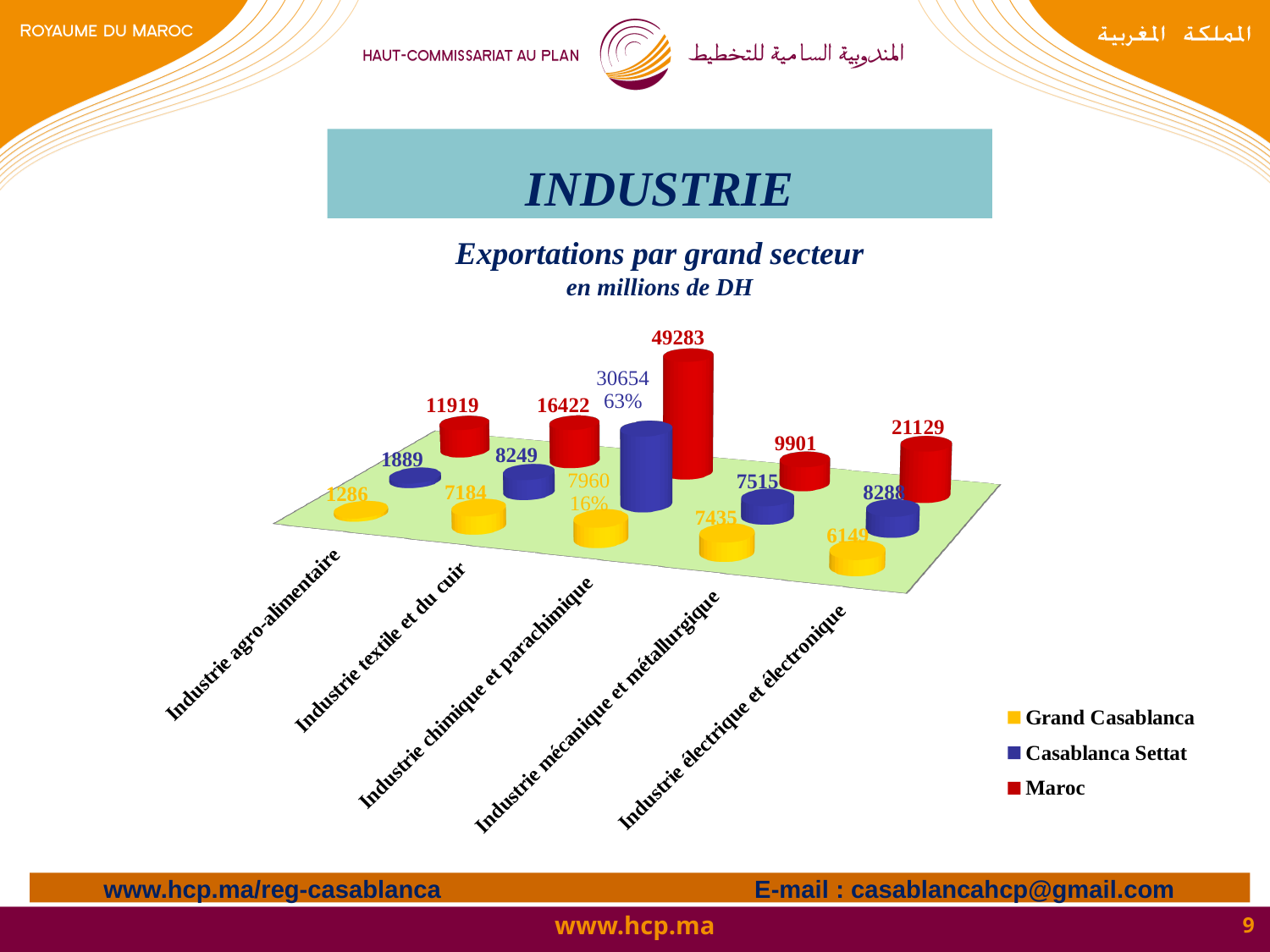
How many sectors are shown on the x axis? 5 What is the difference between the Maroc value and the Casablanca Settat value for Industrie chimique et parachimique? 18629 What is the Casablanca Settat value for Industrie électrique et électronique? 8288 How many series does the legend list? 3 What percentage is shown next to the Casablanca Settat value for Industrie chimique et parachimique? 63% What is the Maroc value for Industrie textile et du cuir? 16422 Which is larger for Industrie électrique et électronique: the Grand Casablanca value or the Casablanca Settat value? Casablanca Settat What is the Maroc value for Industrie chimique et parachimique? 49283 What kind of chart is shown? Bar chart Which sector has the lowest Grand Casablanca value? Industrie agro-alimentaire Which sector has the highest Maroc value? Industrie chimique et parachimique What is the Grand Casablanca value for Industrie agro-alimentaire? 1286